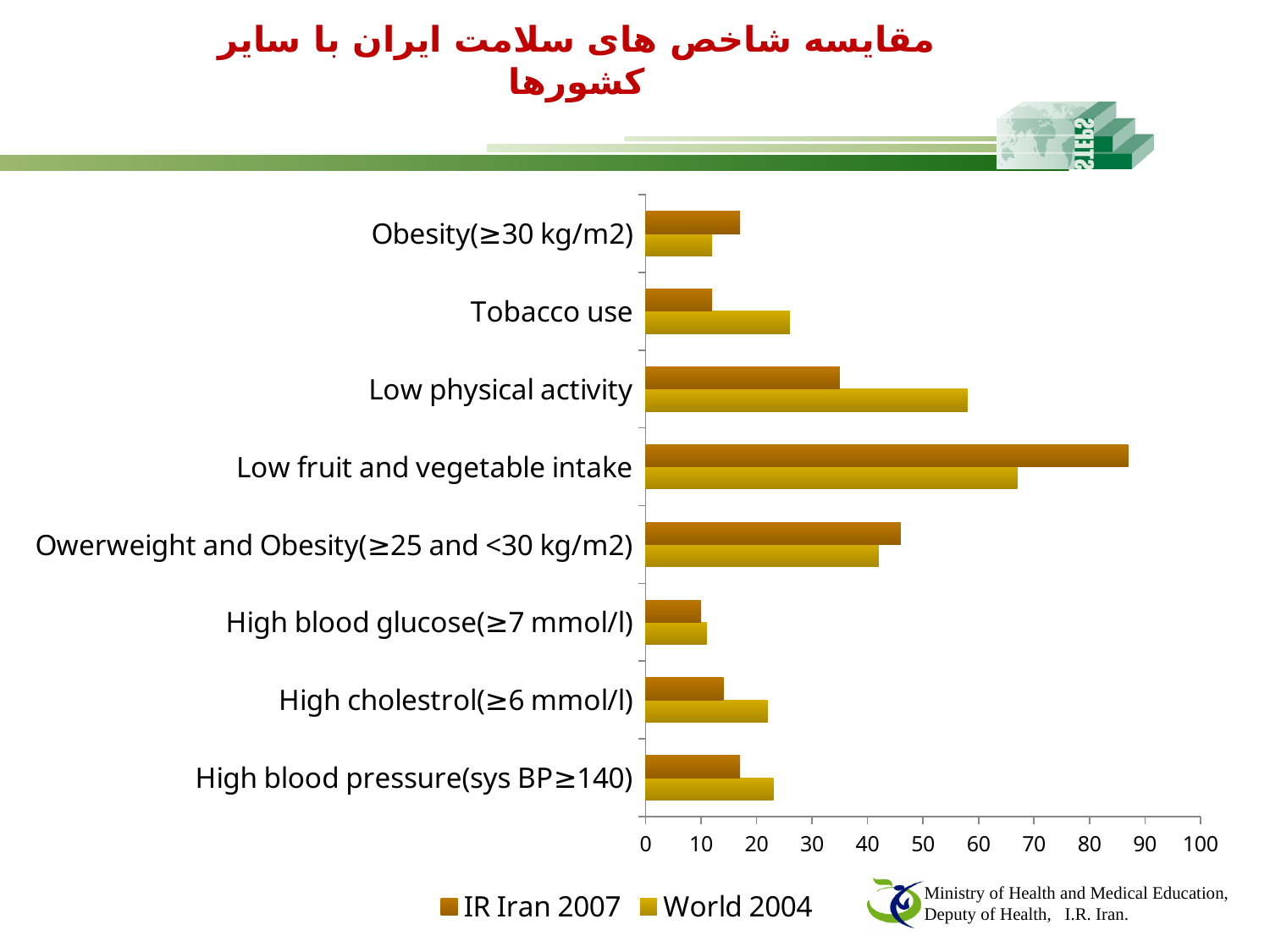
Is the World 2004 value for Low physical activity greater or less than 50? greater Which category has the highest value for IR Iran 2007? Low fruit and vegetable intake Is the IR Iran 2007 value for Tobacco use greater or less than 20? less For Low physical activity, which series has the larger value, IR Iran 2007 or World 2004? World 2004 How many series does the legend list? 2 Which category has the highest value for World 2004? Low fruit and vegetable intake What are the two series named in the legend? IR Iran 2007 and World 2004 For Tobacco use, which series has the larger value, IR Iran 2007 or World 2004? World 2004 How many categories are plotted on the chart? 8 Is the IR Iran 2007 value for Low fruit and vegetable intake greater or less than 80? greater For Low fruit and vegetable intake, which series has the larger value, IR Iran 2007 or World 2004? IR Iran 2007 What kind of chart is shown on the slide? Bar chart